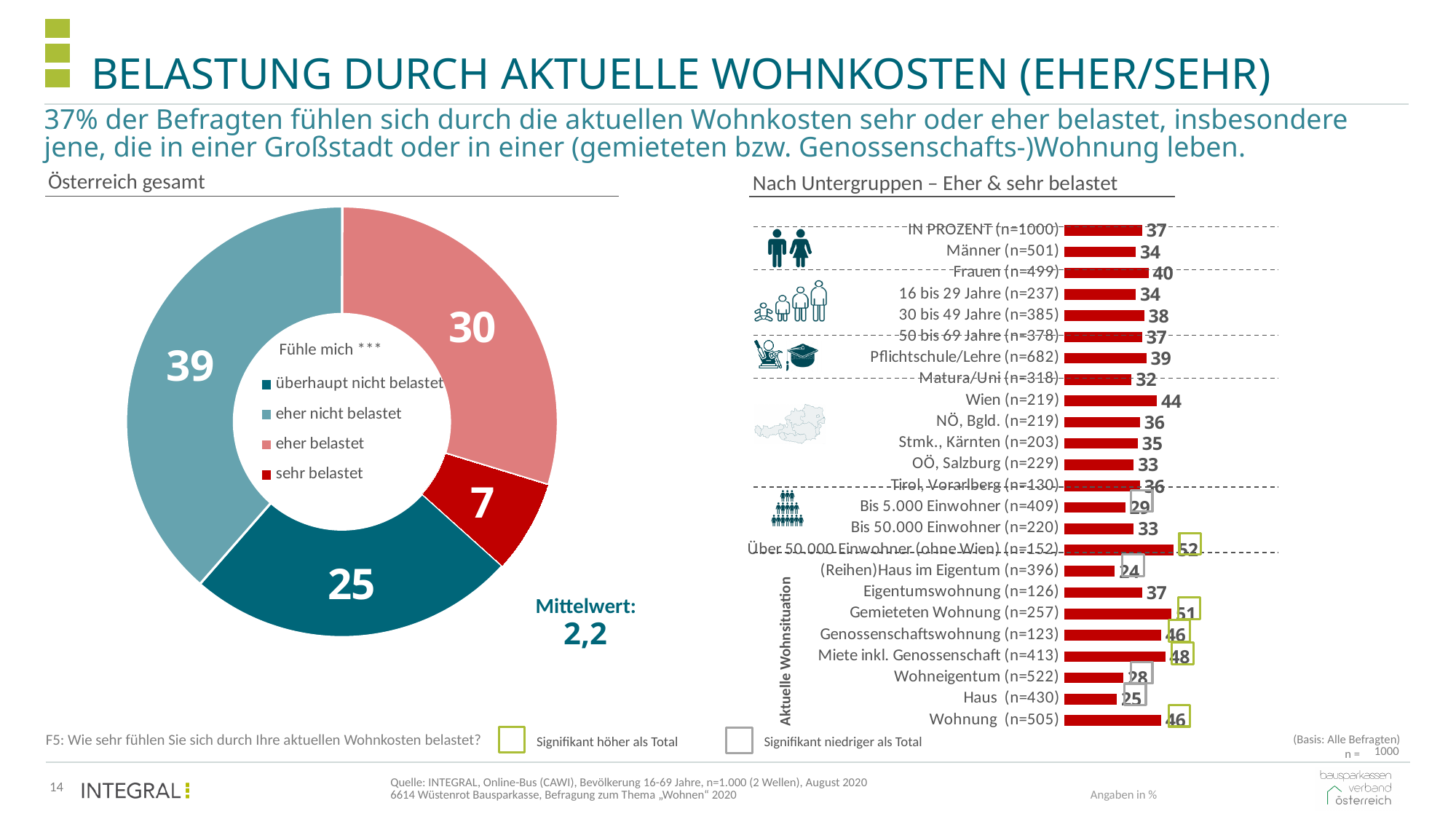
In the 'Nach Untergruppen' bar chart, what is the value for Wien (n=219)? 44 What type of chart is the 'Nach Untergruppen – Eher & sehr belastet' chart? Bar chart In the 'Österreich gesamt' donut chart, how many categories does the legend list? 4 In the 'Nach Untergruppen' bar chart, which subgroup has the highest value? Über 50.000 Einwohner (ohne Wien) (n=152) In the 'Nach Untergruppen' bar chart, what is the value for Frauen (n=499)? 40 What type of chart is the 'Österreich gesamt' chart? Donut (pie) chart In the 'Österreich gesamt' donut chart, what is the value for 'eher nicht belastet'? 39 In the 'Österreich gesamt' donut chart, which category has the largest share? eher nicht belastet In the 'Nach Untergruppen' bar chart, which is larger: Männer (n=501) or Frauen (n=499)? Frauen (n=499) In the 'Österreich gesamt' donut chart, what is the value for 'sehr belastet'? 7 In the 'Nach Untergruppen' bar chart, what is the difference between Gemieteten Wohnung (n=257) and Eigentumswohnung (n=126)? 14 In the 'Nach Untergruppen' bar chart, which subgroup has the lowest value? (Reihen)Haus im Eigentum (n=396)